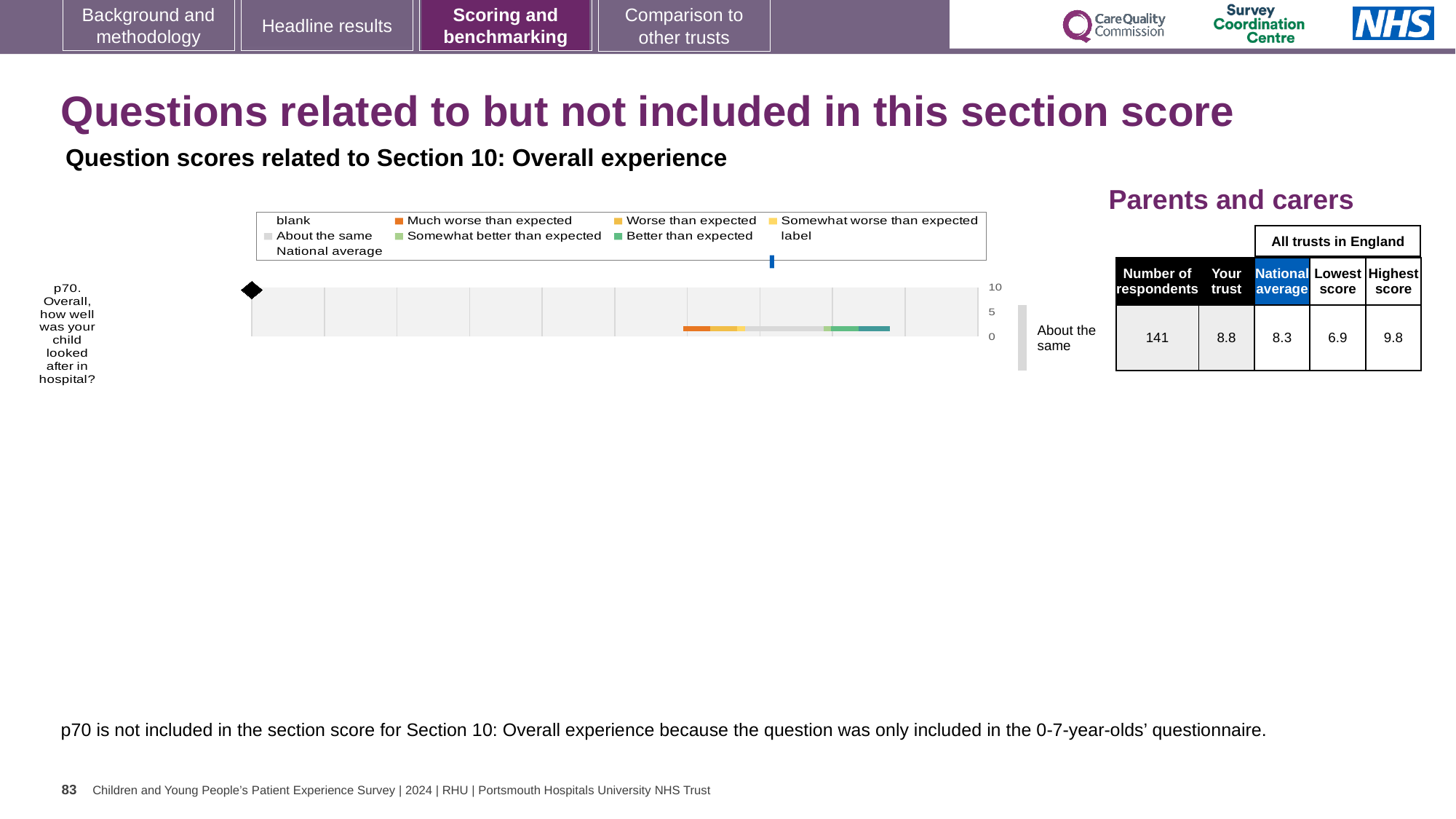
How many questions (categories) are plotted in the chart? 1 What is the difference between the 'Your trust' score and the national average for p70? 0.5 What is the highest value shown on the chart's axis? 10 In the table beside the chart, what is the 'Your trust' score for p70? 8.8 In the table beside the chart, what is the national average score for p70? 8.3 In the table beside the chart, how many respondents answered p70? 141 What comparison label is shown to the right of the p70 bar? About the same How many entries does the chart legend list? 9 Which is larger for p70: the 'Your trust' score or the national average? Your trust What is the difference between the highest score (9.8) and the lowest score (6.9) for p70? 2.9 Which question is plotted in the chart? p70. Overall, how well was your child looked after in hospital? What kind of chart is shown on the slide? bar chart